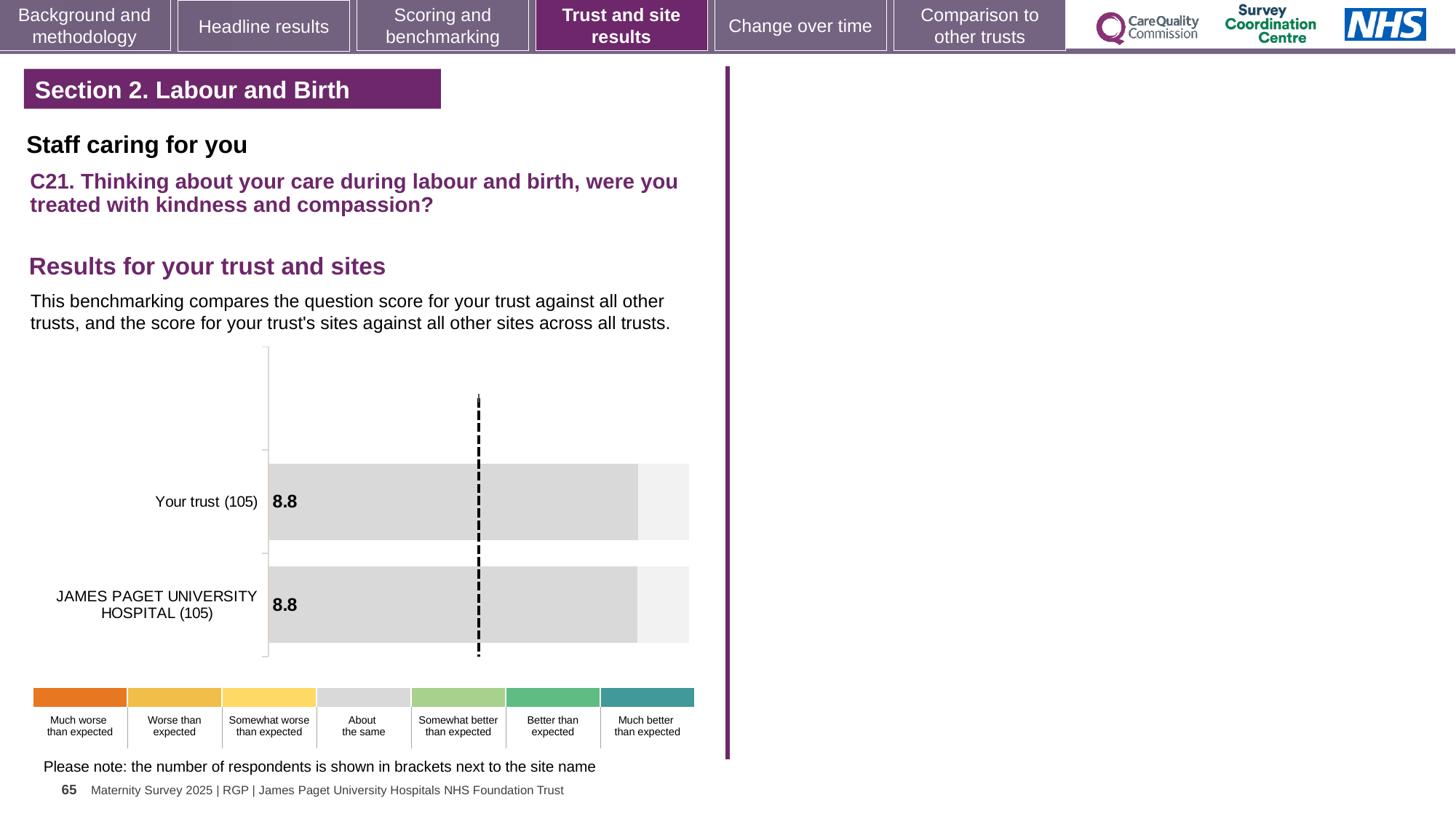
What is the score for Your trust (105)? 8.8 Which benchmarking category does the grey colour of the bars correspond to in the key below the chart? About the same How many respondents are shown in brackets for Your trust? 105 How many bars are plotted in the chart? 2 What is the difference between the score for Your trust and the score for JAMES PAGET UNIVERSITY HOSPITAL? 0 What kind of chart is shown on the slide? Bar chart Is the score for Your trust the same as the score for JAMES PAGET UNIVERSITY HOSPITAL? Yes What is the score for JAMES PAGET UNIVERSITY HOSPITAL (105)? 8.8